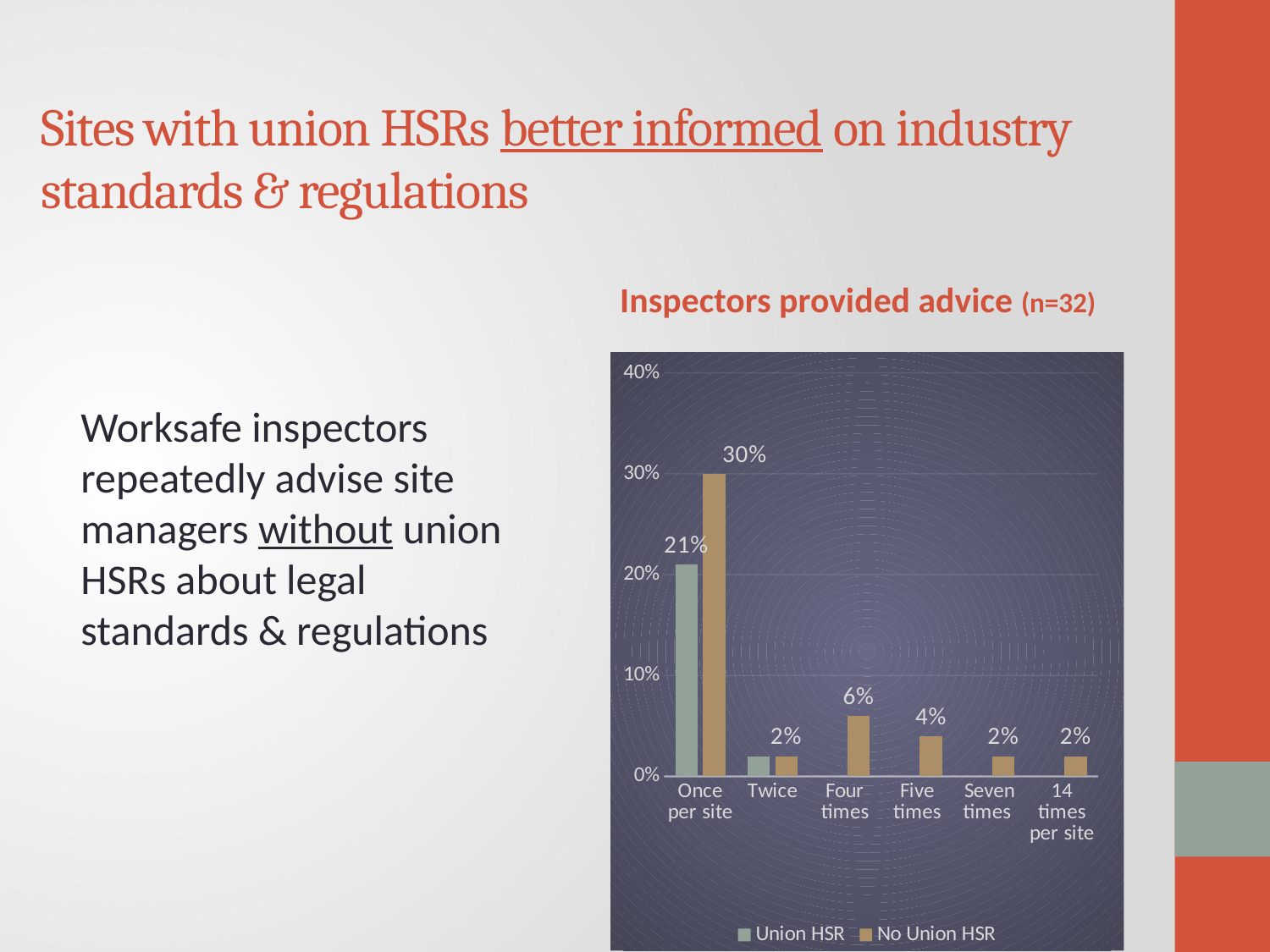
How many categories are shown on the x axis? 6 In the Once per site category, which series has the larger value, Union HSR or No Union HSR? No Union HSR What is the title of the chart? Inspectors provided advice (n=32) What is the value for No Union HSR in the Four times category? 6% What is the value for No Union HSR in the Once per site category? 30% What is the value for No Union HSR in the Five times category? 4% What is the value for Union HSR in the Once per site category? 21% Is the Union HSR value for Once per site greater or less than 20%? greater In the Once per site category, what is the difference between the No Union HSR value and the Union HSR value? 9% What kind of chart is shown on the slide? Bar chart How many series does the legend list? 2 Which category has the highest value for No Union HSR? Once per site